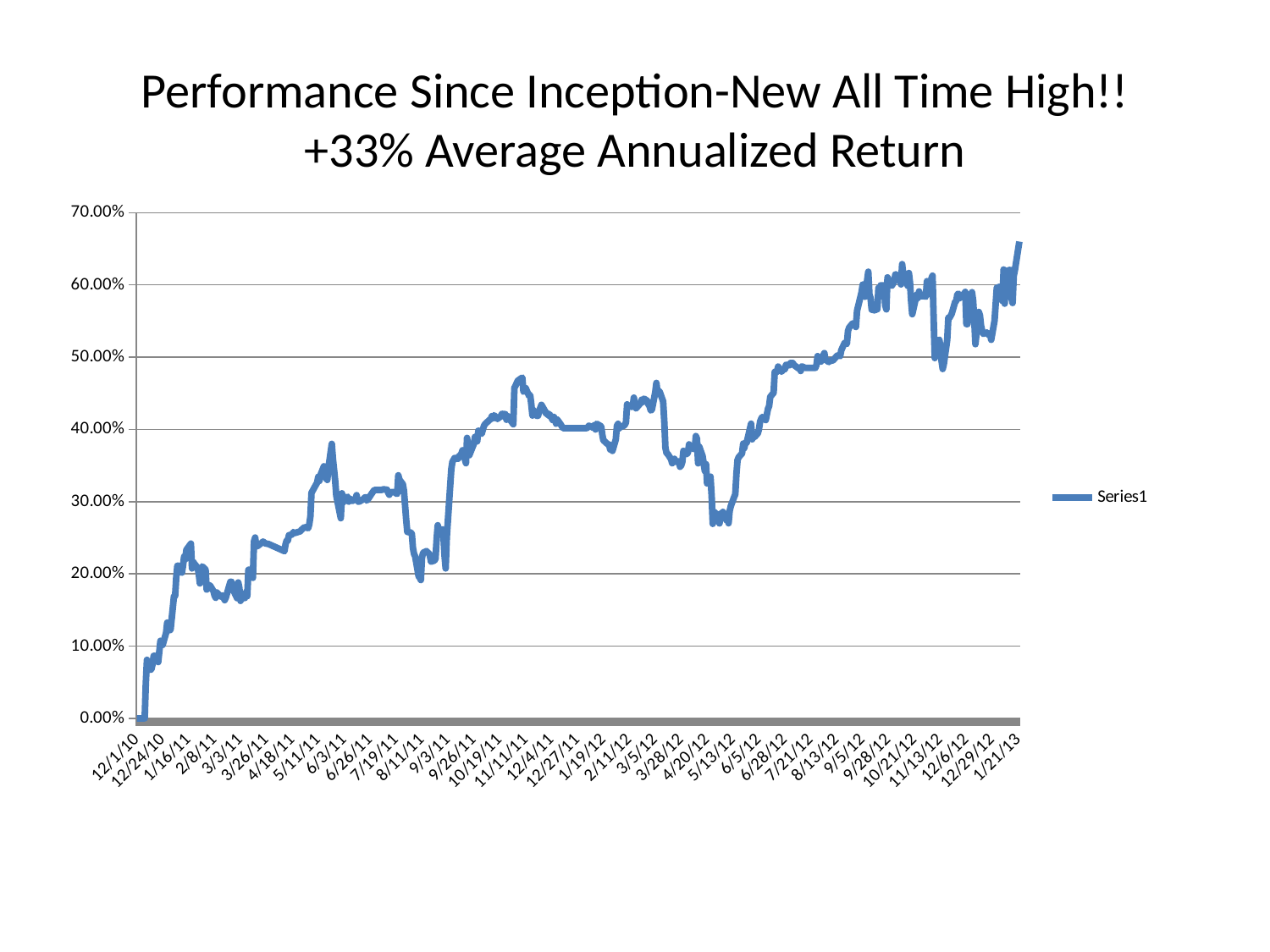
Is the value around 9/5/12 greater or less than 50.00%? greater Is the value at 1/21/13 larger or smaller than the value at 12/1/10? larger What kind of chart is shown on the slide? line chart Is the value around 2/8/11 greater or less than 30.00%? less Is the value at 1/21/13 greater or less than 60.00%? greater What is the name of the series shown in the legend? Series1 How many series does the legend list? 1 What is the value at the first date, 12/1/10? 0.00% What is the title of the chart on the slide? Performance Since Inception-New All Time High!! +33% Average Annualized Return Overall, do the values rise or fall from the left of the x axis to the right? rise